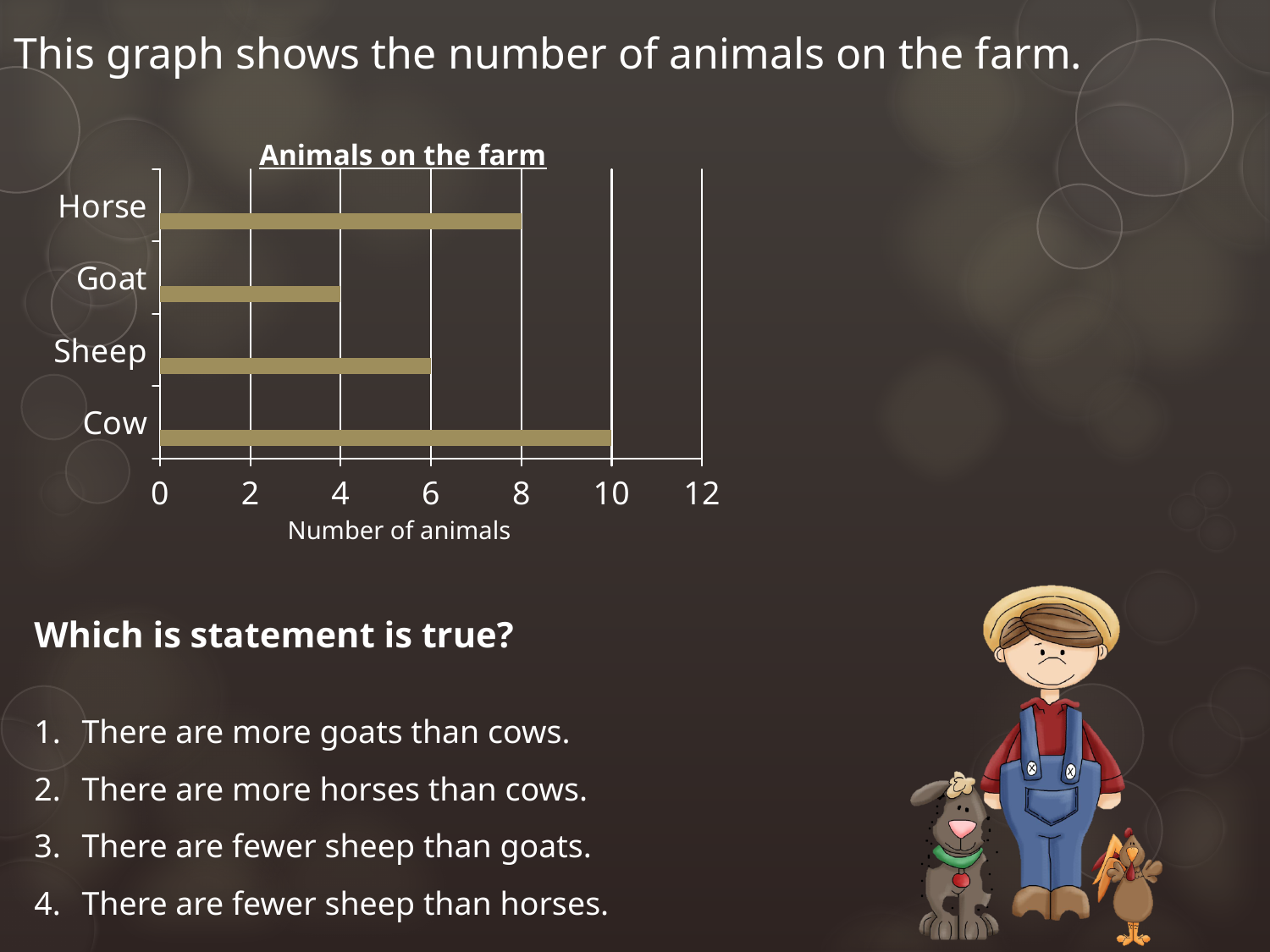
What is the number of cows on the farm according to the chart? 10 Are there more sheep or more horses on the farm? Horses What is the title of the chart? Animals on the farm What kind of chart is shown on the slide? bar chart What is the number of goats on the farm according to the chart? 4 Which animal has the highest number on the farm? Cow How many more cows than goats are there on the farm? 6 How many animal categories are shown in the chart? 4 What is the label of the horizontal axis? Number of animals What is the number of horses on the farm according to the chart? 8 What is the number of sheep on the farm according to the chart? 6 Which animal has the lowest number on the farm? Goat